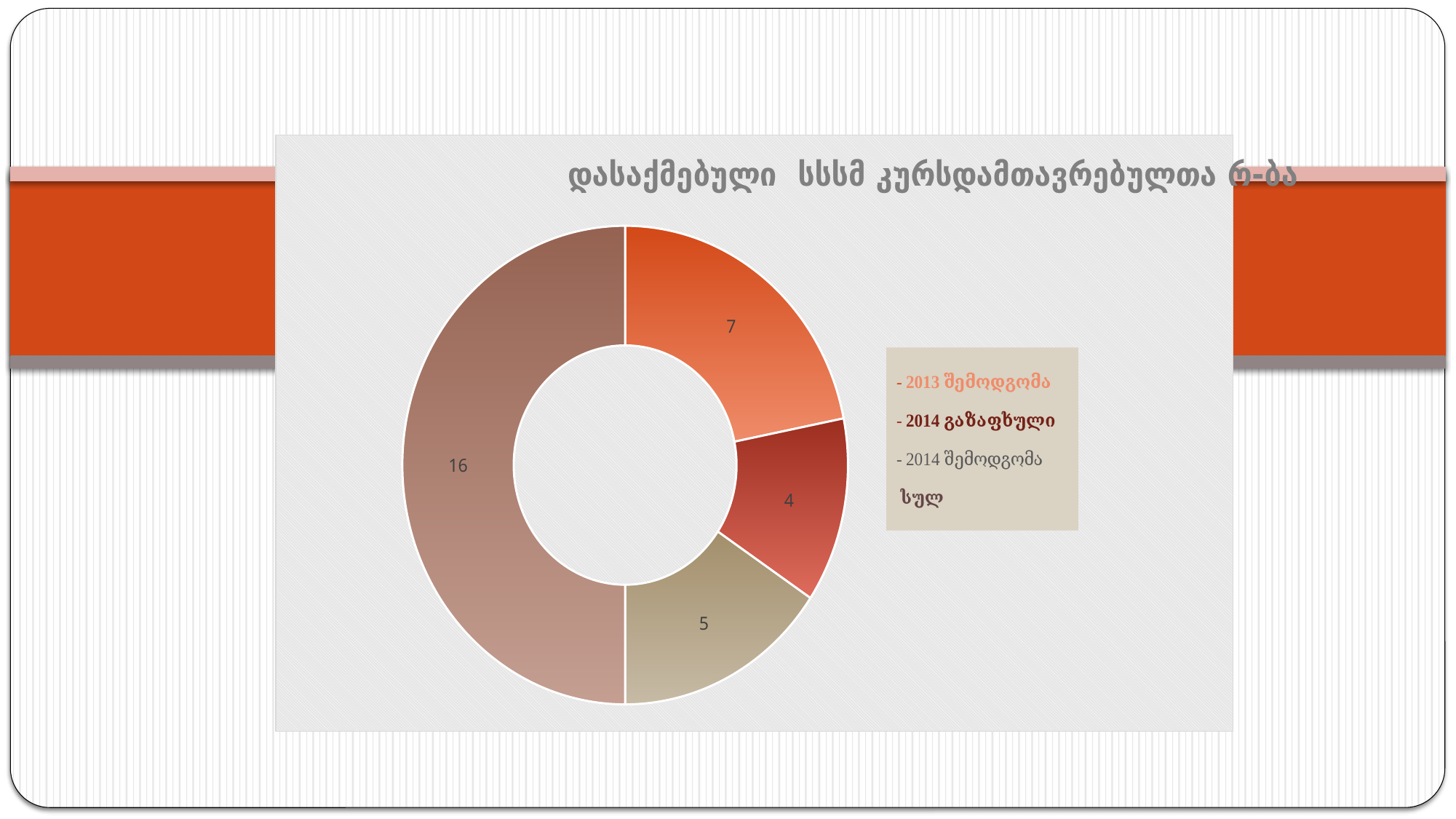
What is the title of the chart? დასაქმებული სსსმ კურსდამთავრებულთა რ-ბა How many slices does the chart have? 4 Which slice has the largest value? სულ What share of the whole chart does the სულ slice represent? 50% What is the value of the slice for 2014 გაზაფხული? 4 Which is larger, the value for 2014 შემოდგომა or the value for 2014 გაზაფხული? 2014 შემოდგომა Which slice has the smallest value? 2014 გაზაფხული What is the value of the slice labelled სულ? 16 What kind of chart is shown on the slide? doughnut chart What is the value of the slice for 2013 შემოდგომა? 7 What is the value of the slice for 2014 შემოდგომა? 5 What is the difference between the values for 2013 შემოდგომა and 2014 გაზაფხული? 3